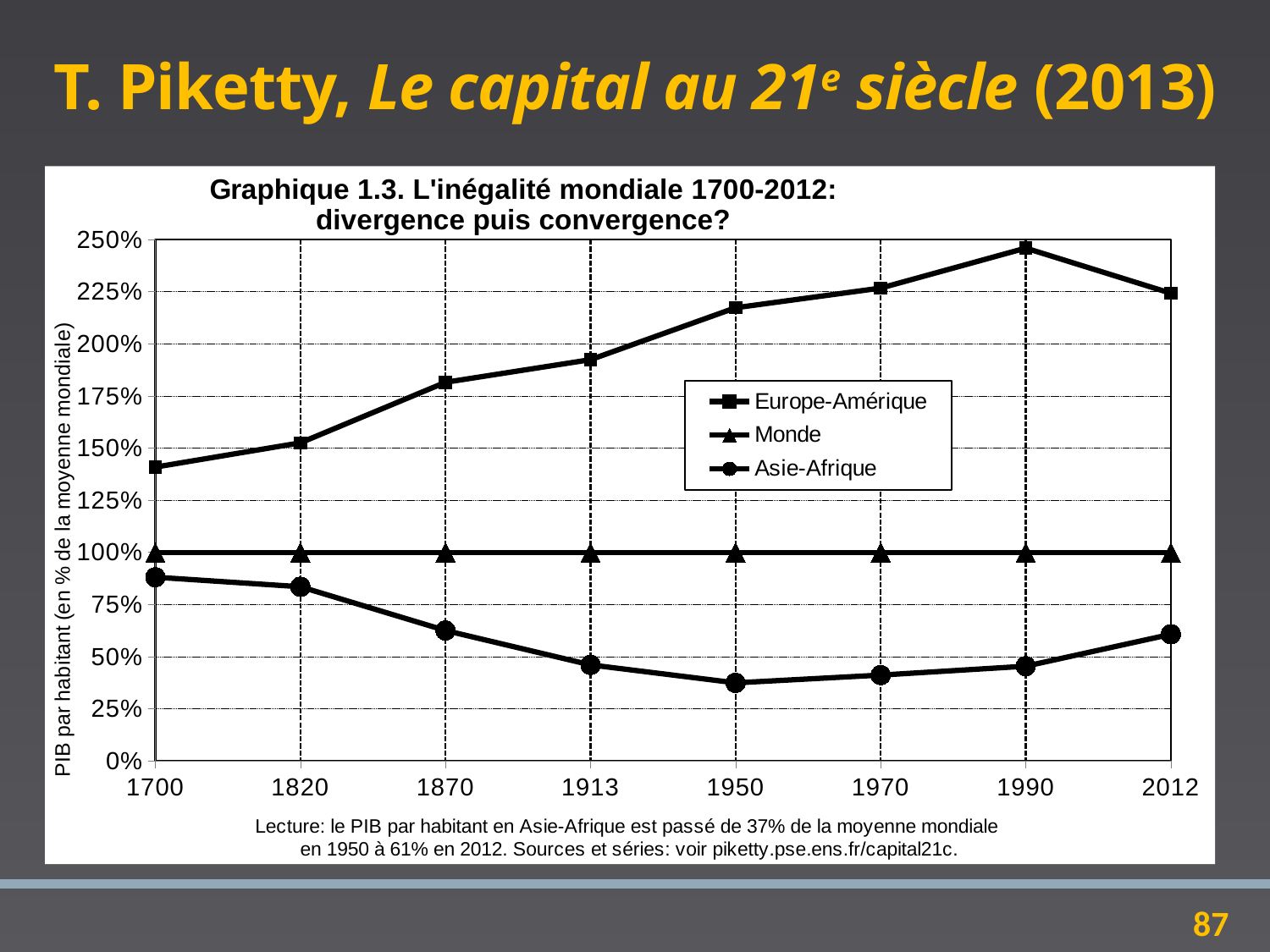
In which year does the Europe-Amérique series reach its highest value? 1990 Is the value for Europe-Amérique in 2012 greater or less than 200%? greater How many series does the legend list? 3 In which year does the Asie-Afrique series reach its lowest value? 1950 What kind of chart is shown on the slide? line chart How many years are marked along the x axis? 8 By how many percentage points did the Asie-Afrique value rise between 1950 and 2012? 24 percentage points According to the slide, what was the value for Asie-Afrique in 2012? 61% According to the slide, what was the value for Asie-Afrique in 1950? 37% What value does the Monde series hold across all years? 100% Is the value for Europe-Amérique in 1700 greater or less than 150%? less Does the Europe-Amérique series rise or fall between 1700 and 1990? rise